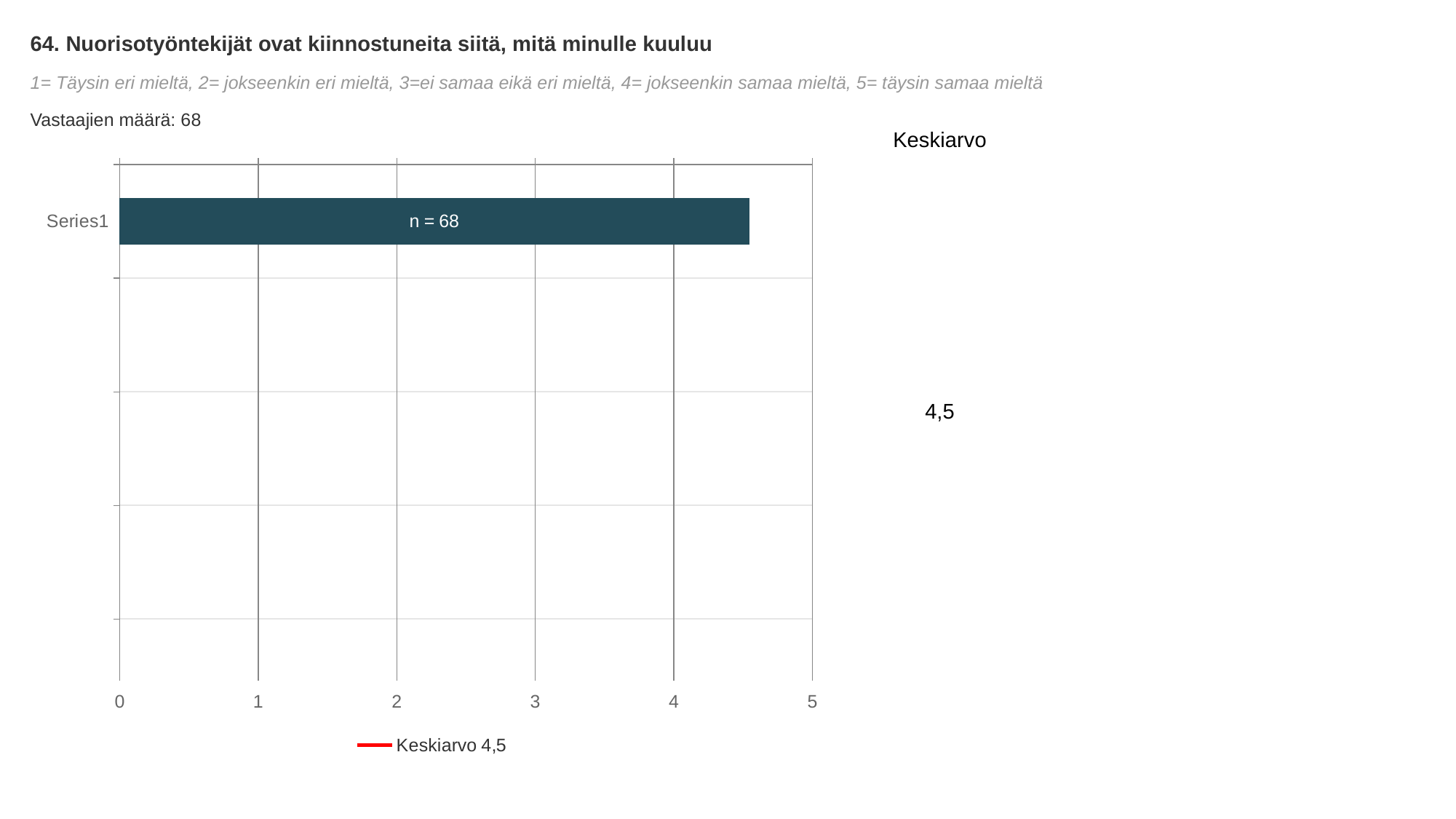
How many bars are plotted in the chart? 1 Is the value of the Series1 bar greater or less than 4? greater What is the highest value shown on the horizontal axis? 5 What is the label of the single category on the vertical axis? Series1 What does the legend entry below the chart say? Keskiarvo 4,5 Is the value of the Series1 bar greater or less than 5? less What data label is printed on the bar? n = 68 How many respondents (Vastaajien määrä) are reported on the slide? 68 What is the Keskiarvo (mean) value shown on the slide? 4,5 What kind of chart is shown on the slide? bar chart